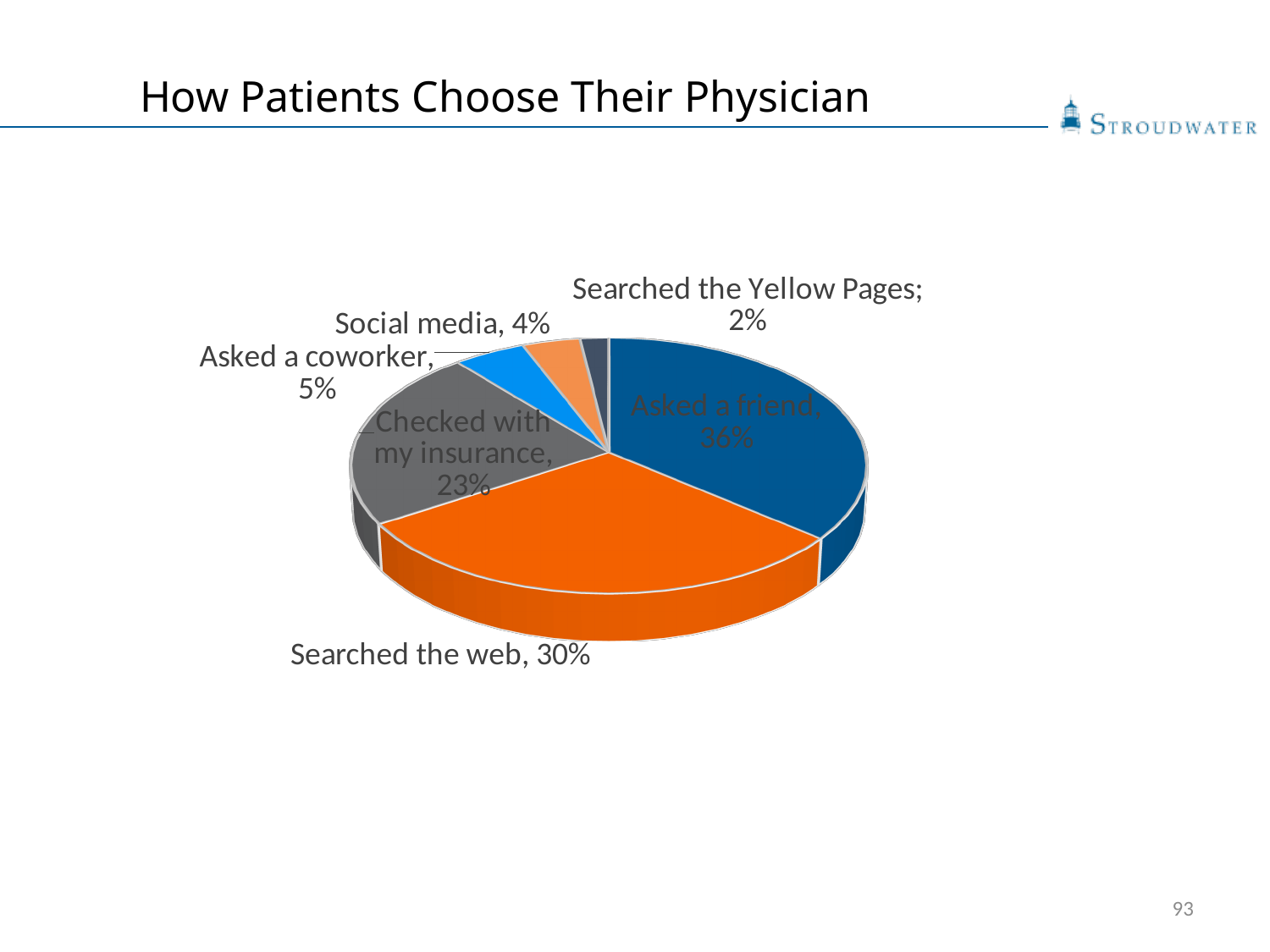
How many slices does the pie chart have? 6 What percentage of patients searched the web to choose their physician? 30% What is the difference in percentage points between 'Asked a friend' and 'Searched the web'? 6 Which method has the smallest share of the pie? Searched the Yellow Pages What kind of chart is shown on the slide? Pie chart What percentage of patients asked a coworker? 5% What percentage of patients chose their physician by asking a friend? 36% What percentage of patients searched the Yellow Pages? 2% What percentage of patients used social media? 4% What percentage of patients checked with their insurance? 23% Which is larger: the share for 'Checked with my insurance' or 'Searched the web'? Searched the web Which method has the largest share of the pie? Asked a friend